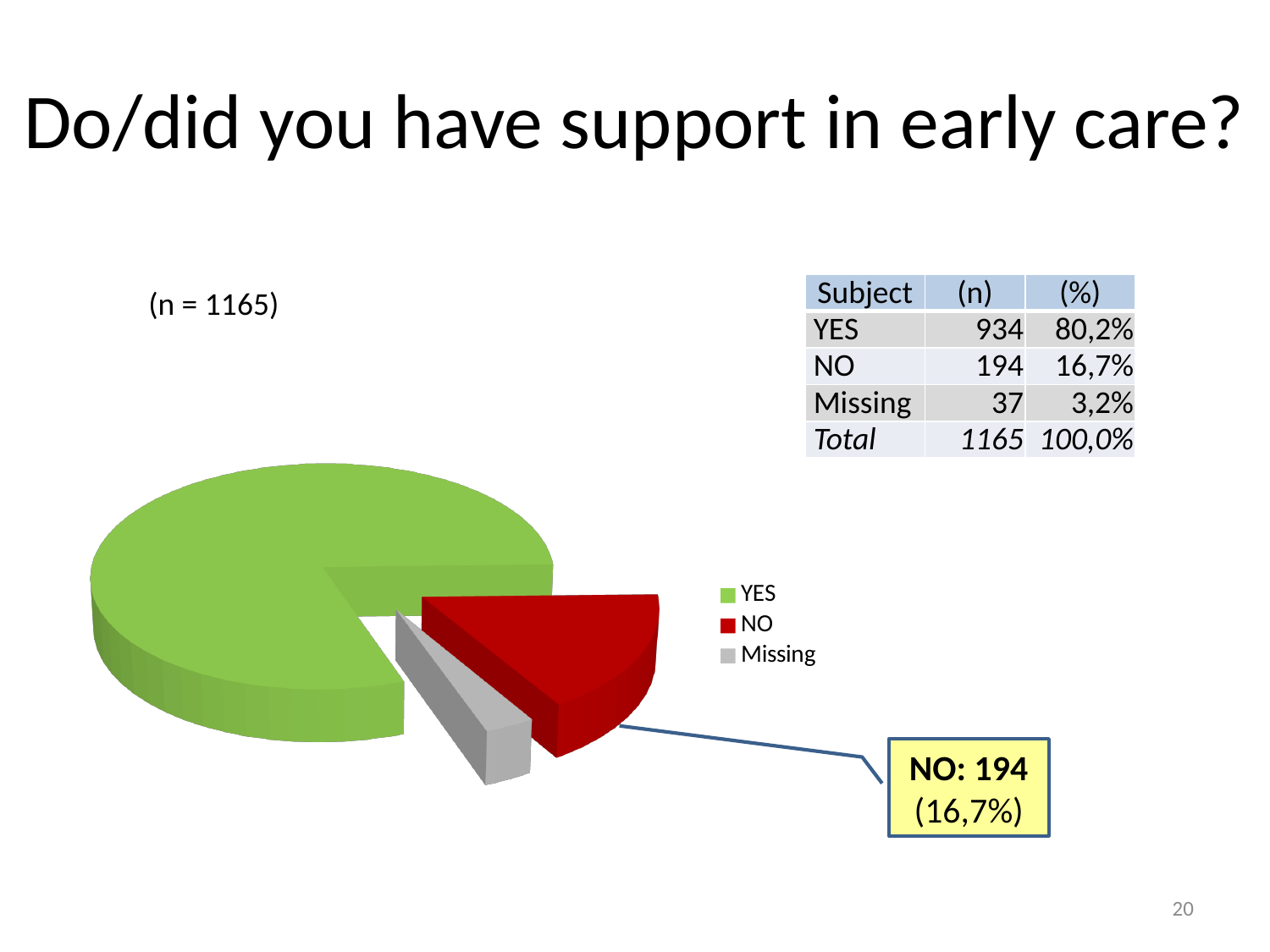
What kind of chart is shown on the slide? pie chart How many entries does the legend of the pie chart list? 3 How many slices does the pie chart have? 3 What share of the pie does the NO slice represent, as shown in the callout? 16,7% According to the table on the slide, how many respondents are in the Missing category? 37 What colour is the YES slice in the pie chart? green Is the NO slice or the Missing slice of the pie chart larger? NO Which category has the largest slice of the pie chart? YES According to the table on the slide, what share of the pie does the YES slice represent? 80,2% Which category has the smallest slice of the pie chart? Missing According to the callout on the pie chart, how many respondents answered NO? 194 What is the difference in count between the YES and NO categories, using the values in the table? 740